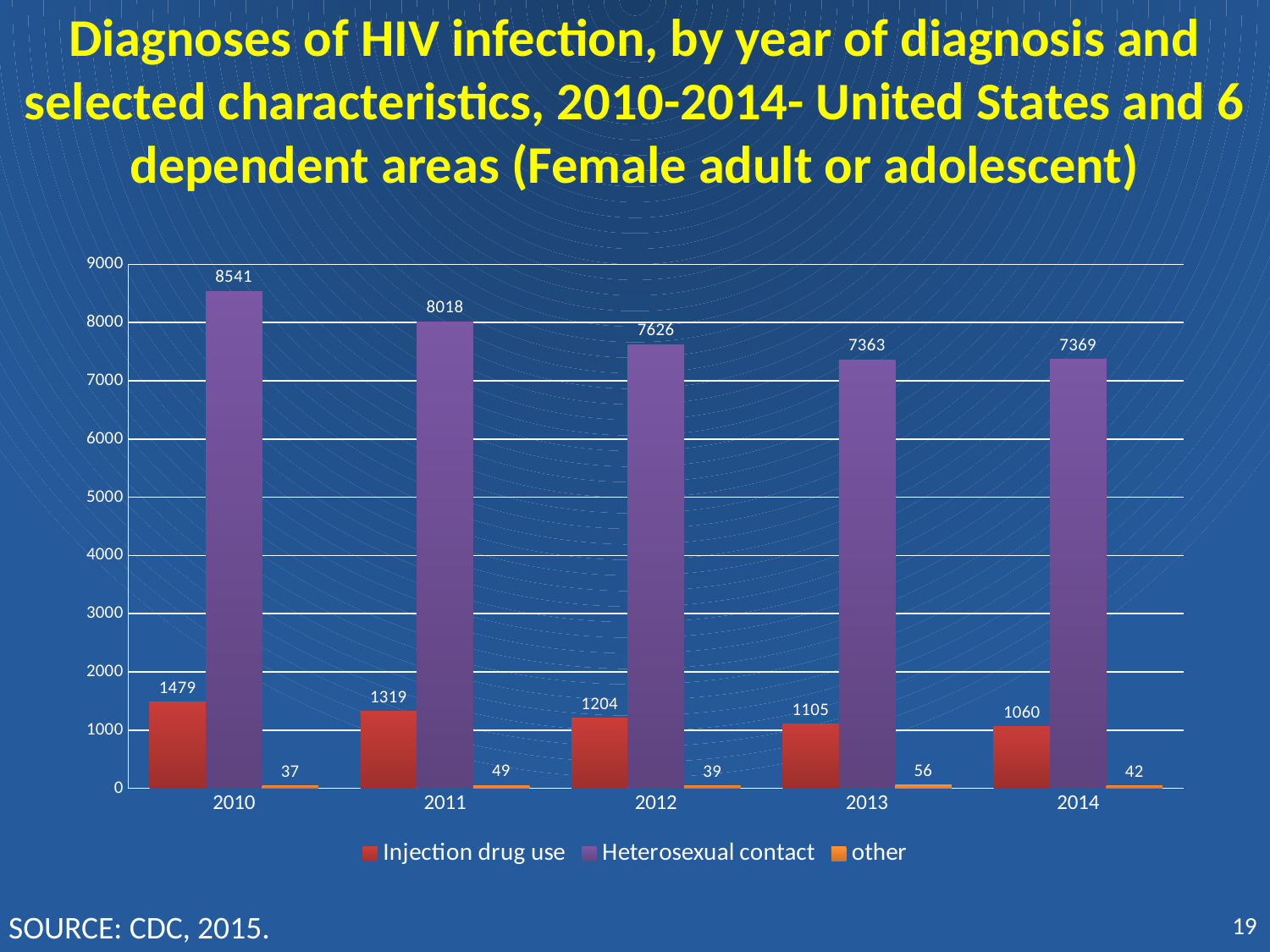
Is the Heterosexual contact value for 2013 greater or less than 8000? less Does the Injection drug use value rise or fall from 2010 to 2014? fall What is the value for Heterosexual contact in 2010? 8541 How many years are shown on the x axis? 5 In which year is the Injection drug use value lowest? 2014 Which is larger: the Injection drug use value in 2011 or in 2012? 2011 How many series does the legend list? 3 What is the value for Injection drug use in 2014? 1060 What is the value for the 'other' series in 2013? 56 What kind of chart is shown on the slide? bar chart In which year is the Heterosexual contact value highest? 2010 What is the difference between the Heterosexual contact values for 2010 and 2011? 523